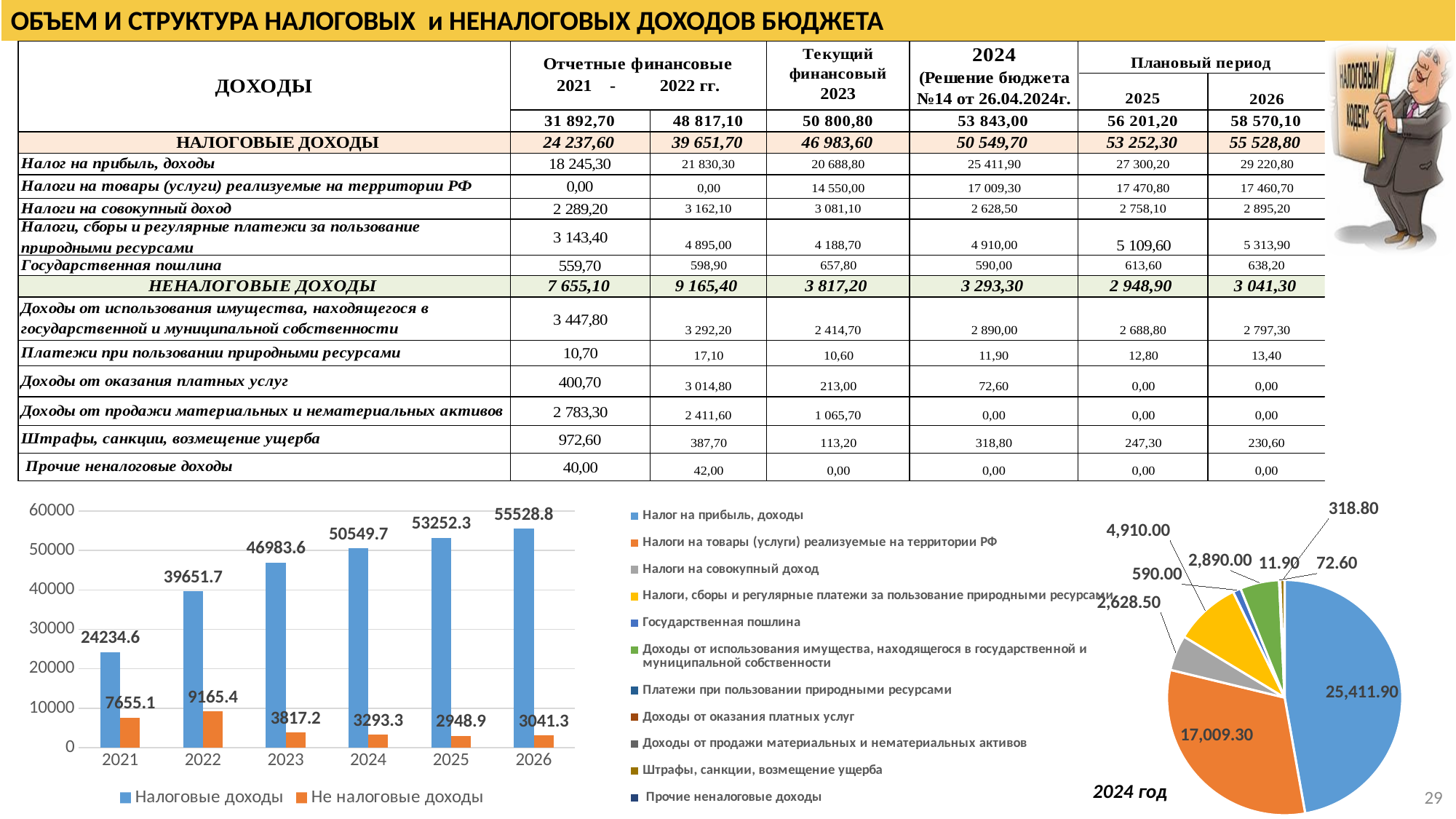
In the bar chart at the bottom left, what is the value of Налоговые доходы for 2026? 55528.8 In the bar chart at the bottom left, is the value of Налоговые доходы for 2023 greater or less than 40000? greater Do the Налоговые доходы values in the bar chart at the bottom left rise or fall from 2021 to 2026? rise In the bar chart at the bottom left, what is the value of Не налоговые доходы for 2023? 3817.2 How many series does the legend of the bar chart at the bottom left list? 2 What kind of chart is the chart at the bottom right of the slide (2024 год)? pie chart How many years are shown on the x axis of the bar chart at the bottom left? 6 In the bar chart at the bottom left, which year has the lowest Не налоговые доходы? 2025 In the bar chart at the bottom left, which is larger: Не налоговые доходы in 2021 or in 2022? 2022 In the pie chart at the bottom right (2024 год), what is the value of the largest slice? 25,411.90 In the bar chart at the bottom left, what is the difference between Налоговые доходы in 2026 and in 2021? 31294.2 In the bar chart at the bottom left, which year has the highest Налоговые доходы? 2026